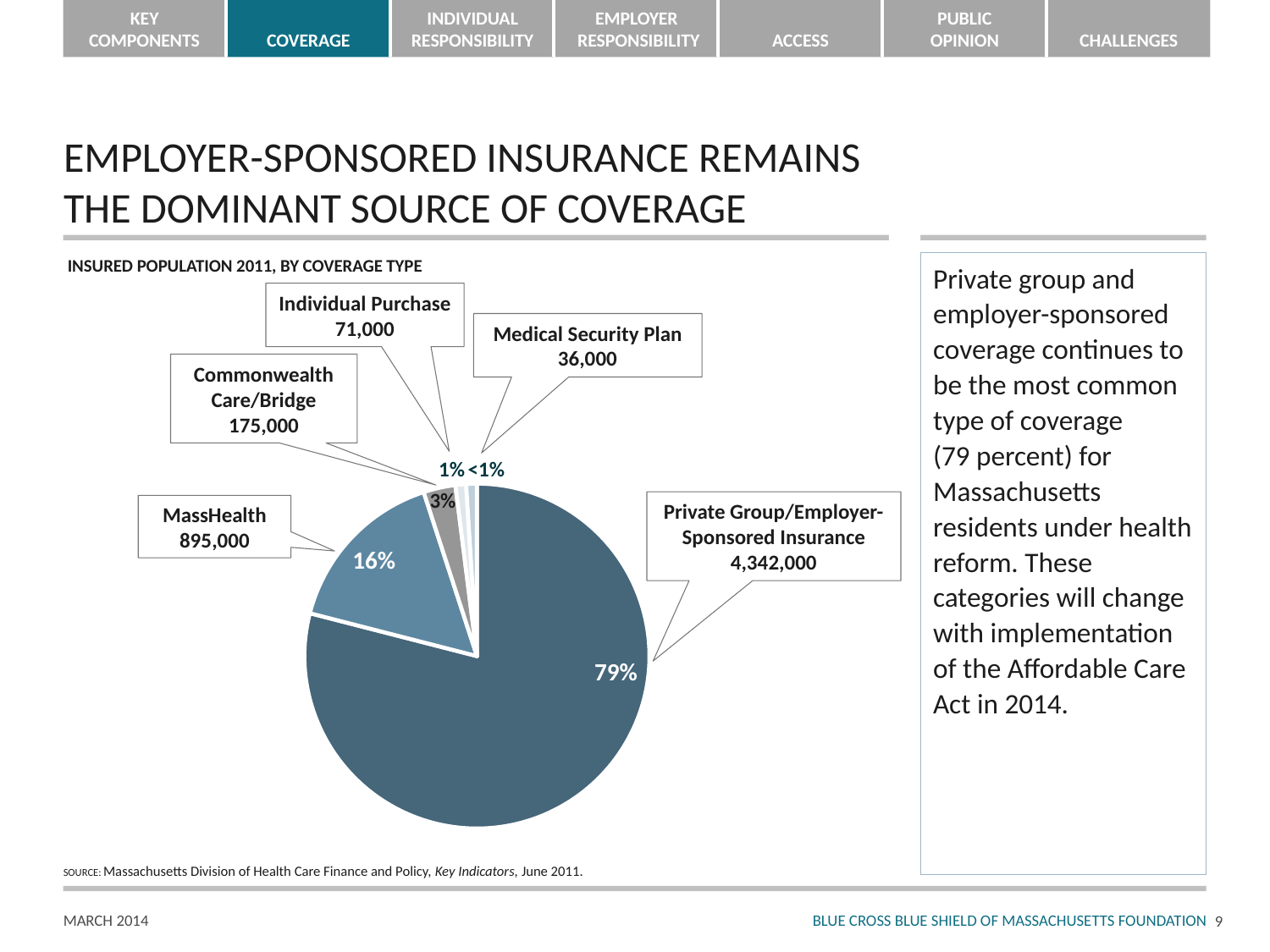
Which coverage type has the largest share of the pie? Private Group/Employer-Sponsored Insurance What is the insured population value for Individual Purchase? 71,000 What kind of chart is shown on the slide? Pie chart What is the insured population value for Commonwealth Care/Bridge? 175,000 What is the insured population value for MassHealth? 895,000 What is the difference between the MassHealth value and the Commonwealth Care/Bridge value? 720,000 What percentage share of the pie does MassHealth represent? 16% What is the insured population value for Private Group/Employer-Sponsored Insurance? 4,342,000 How many coverage types are shown in the pie chart? 5 What is the title of the chart? Insured Population 2011, by Coverage Type Which coverage type has the smallest share of the pie? Medical Security Plan What is the insured population value for Medical Security Plan? 36,000